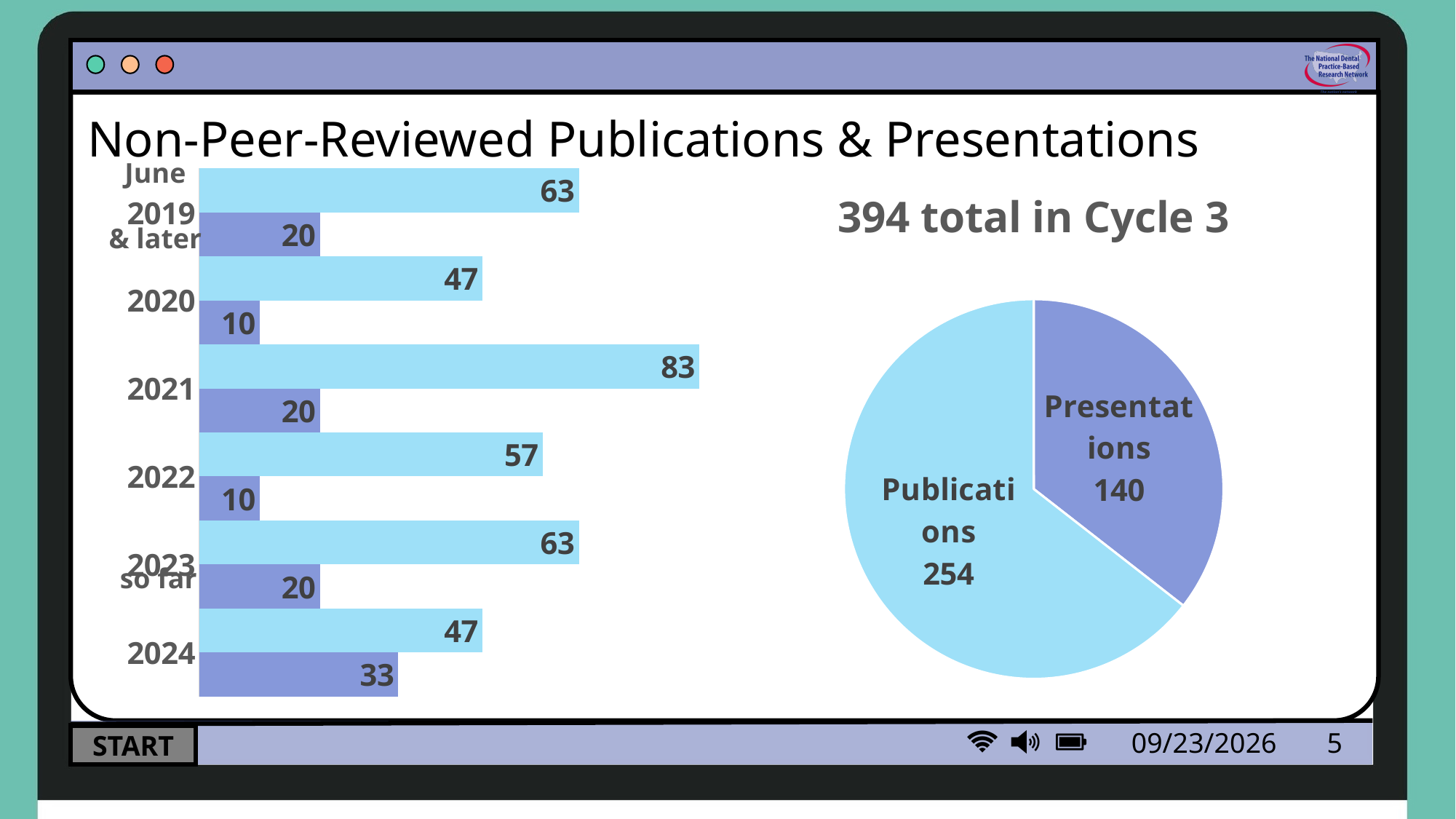
What type of chart is on the left side of the slide? bar chart In the bar chart, which year has the highest purple bar? 2024 In the bar chart, what is the value of the light blue bar for 2021? 83 In the pie chart, what is the value of the Presentations slice? 140 In the bar chart, what is the value of the purple bar for 2024? 33 In the bar chart, which is larger: the light blue bar for 2020 or the light blue bar for 2022? 2022 In the pie chart, what is the value of the Publications slice? 254 In the bar chart, which year has the highest light blue bar? 2021 In the bar chart, what is the difference between the light blue bar and the purple bar for 2021? 63 In the bar chart, what is the value of the light blue bar for 2022? 57 What is the title shown above the pie chart? 394 total in Cycle 3 How many year categories does the bar chart show? 6